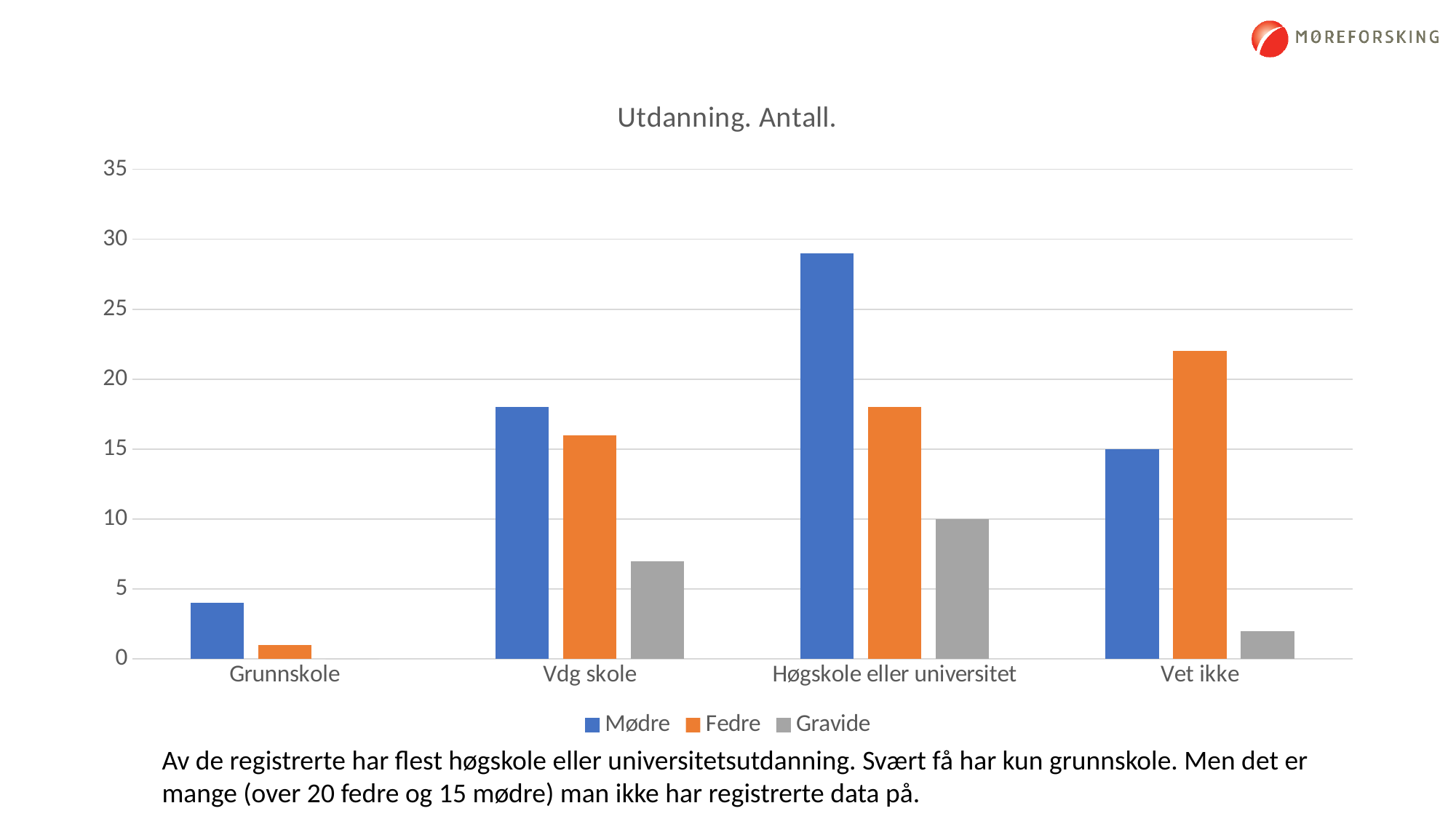
Is the value for Fedre in Vet ikke greater or less than 20? greater How many categories are shown on the x axis? 4 Which series is shown in orange? Fedre What is the title of the chart? Utdanning. Antall. What kind of chart is shown on the slide? bar chart Which category has the highest value for Mødre? Høgskole eller universitet What is the value for Gravide in the Høgskole eller universitet category? 10 In the Vet ikke category, which is larger: Mødre or Fedre? Fedre How many series does the legend list? 3 What is the value for Mødre in the Vet ikke category? 15 Which category has the lowest value for Fedre? Grunnskole Is the value for Mødre in Høgskole eller universitet greater or less than 25? greater